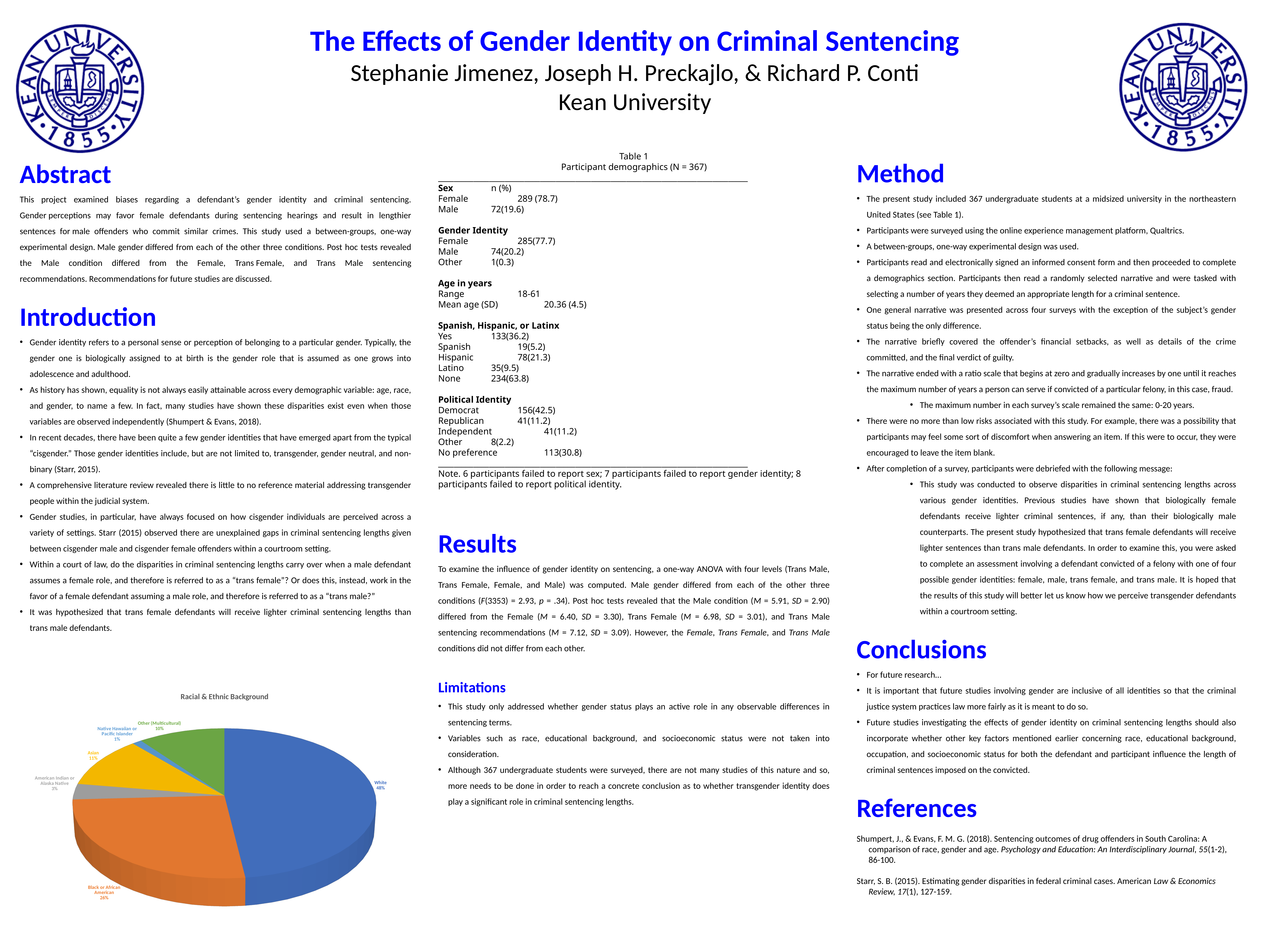
In the "Racial & Ethnic Background" pie chart, how many slices are there? 6 In the "Racial & Ethnic Background" pie chart, what is the difference in percentage points between the White and Black or African American slices? 22 In the "Racial & Ethnic Background" pie chart, what share is labelled for Black or African American? 26% In the "Racial & Ethnic Background" pie chart, which slice is larger, Asian or Other (Multicultural)? Asian What is the title of the pie chart at the bottom left of the slide? Racial & Ethnic Background What kind of chart is the "Racial & Ethnic Background" chart? pie chart In the "Racial & Ethnic Background" pie chart, which category has the smallest slice? Native Hawaiian or Pacific Islander In the "Racial & Ethnic Background" pie chart, what share is labelled for White? 48% In the "Racial & Ethnic Background" pie chart, which category has the largest slice? White In the "Racial & Ethnic Background" pie chart, what share is labelled for Asian? 11% In the "Racial & Ethnic Background" pie chart, what share is labelled for Other (Multicultural)? 10% In the "Racial & Ethnic Background" pie chart, what share is labelled for American Indian or Alaska Native? 3%